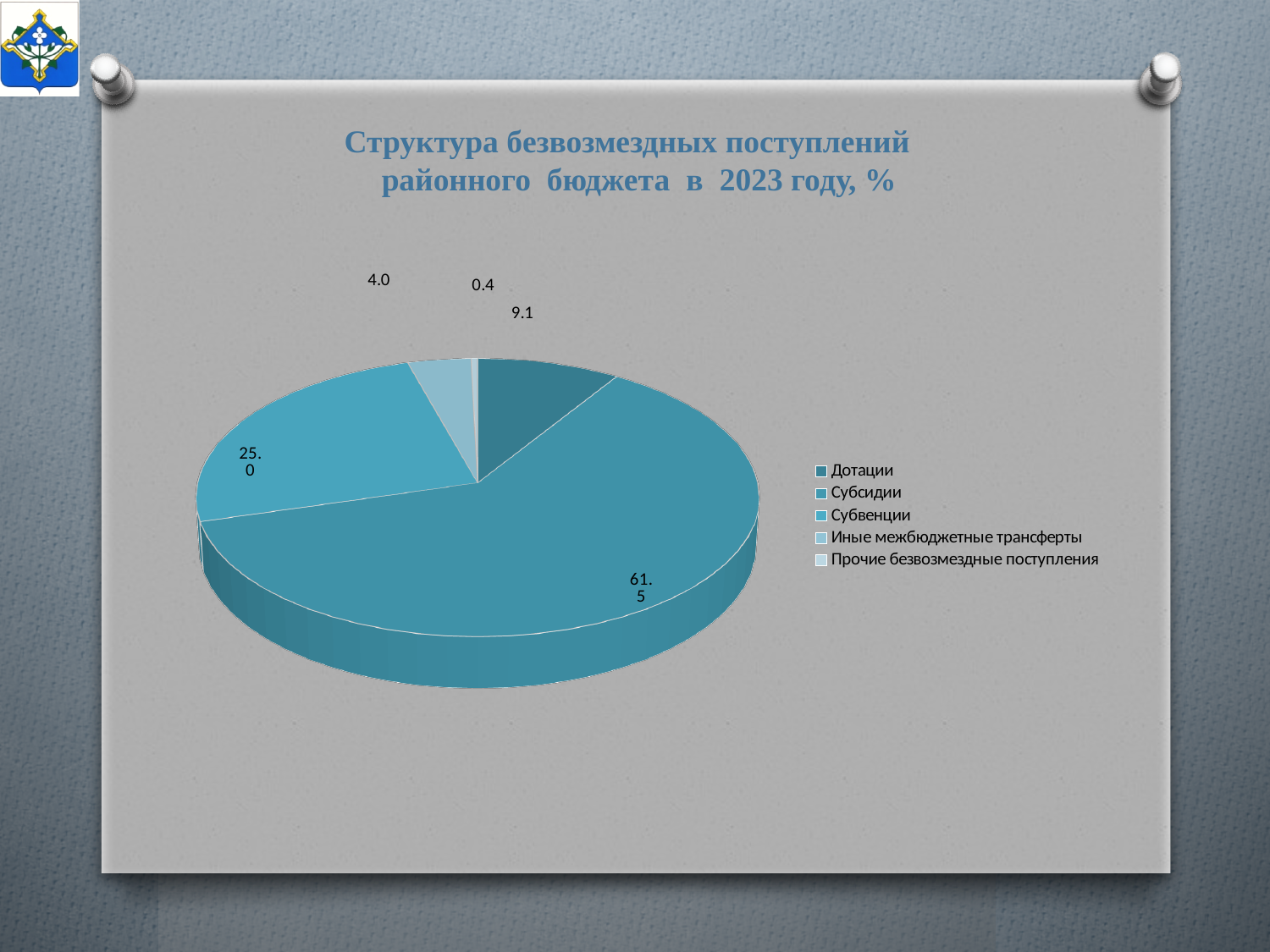
What is the value for Субвенции? 25.0 What is the title of the chart? Структура безвозмездных поступлений районного бюджета в 2023 году, % Which category has the smallest share of the pie? Прочие безвозмездные поступления What is the value for Прочие безвозмездные поступления? 0.4 What is the value for Субсидии? 61.5 What is the difference between the values for Субсидии and Субвенции? 36.5 What is the value for Иные межбюджетные трансферты? 4.0 How many categories does the legend list? 5 Which category has the largest share of the pie? Субсидии Which is larger, Дотации or Иные межбюджетные трансферты? Дотации What type of chart is shown on the slide? pie chart What is the value for Дотации? 9.1